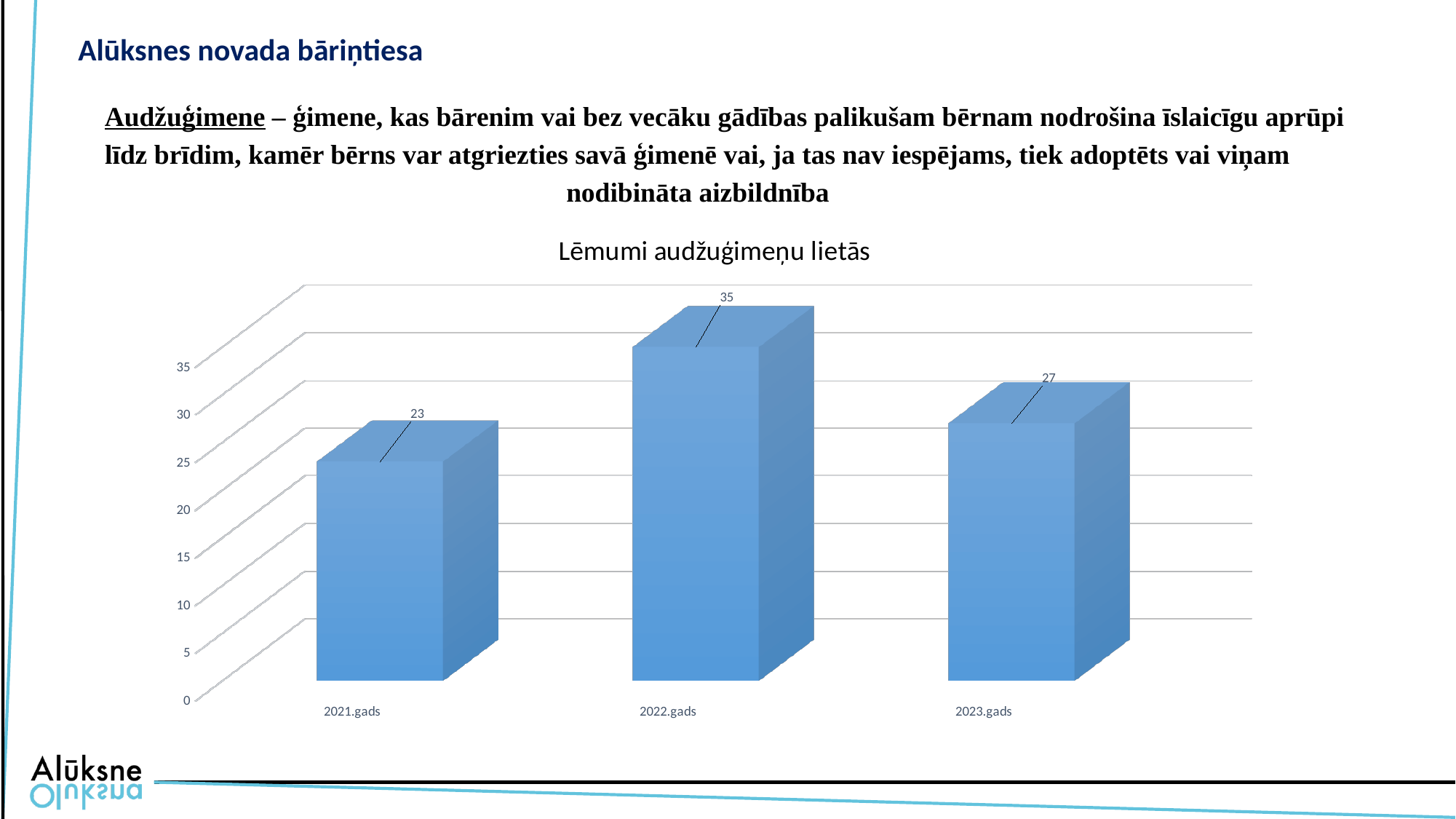
Which year has the highest value? 2022.gads What is the difference between the values for 2023.gads and 2021.gads? 4 What is the value for 2021.gads? 23 What is the value for 2023.gads? 27 What is the difference between the values for 2022.gads and 2021.gads? 12 Which is larger, the value for 2023.gads or the value for 2021.gads? 2023.gads What is the title of the chart? Lēmumi audžuģimeņu lietās How many years are shown on the chart? 3 Which year has the lowest value? 2021.gads What is the value for 2022.gads? 35 What kind of chart is shown on the slide? bar chart Is the value for 2022.gads greater or less than 30? greater